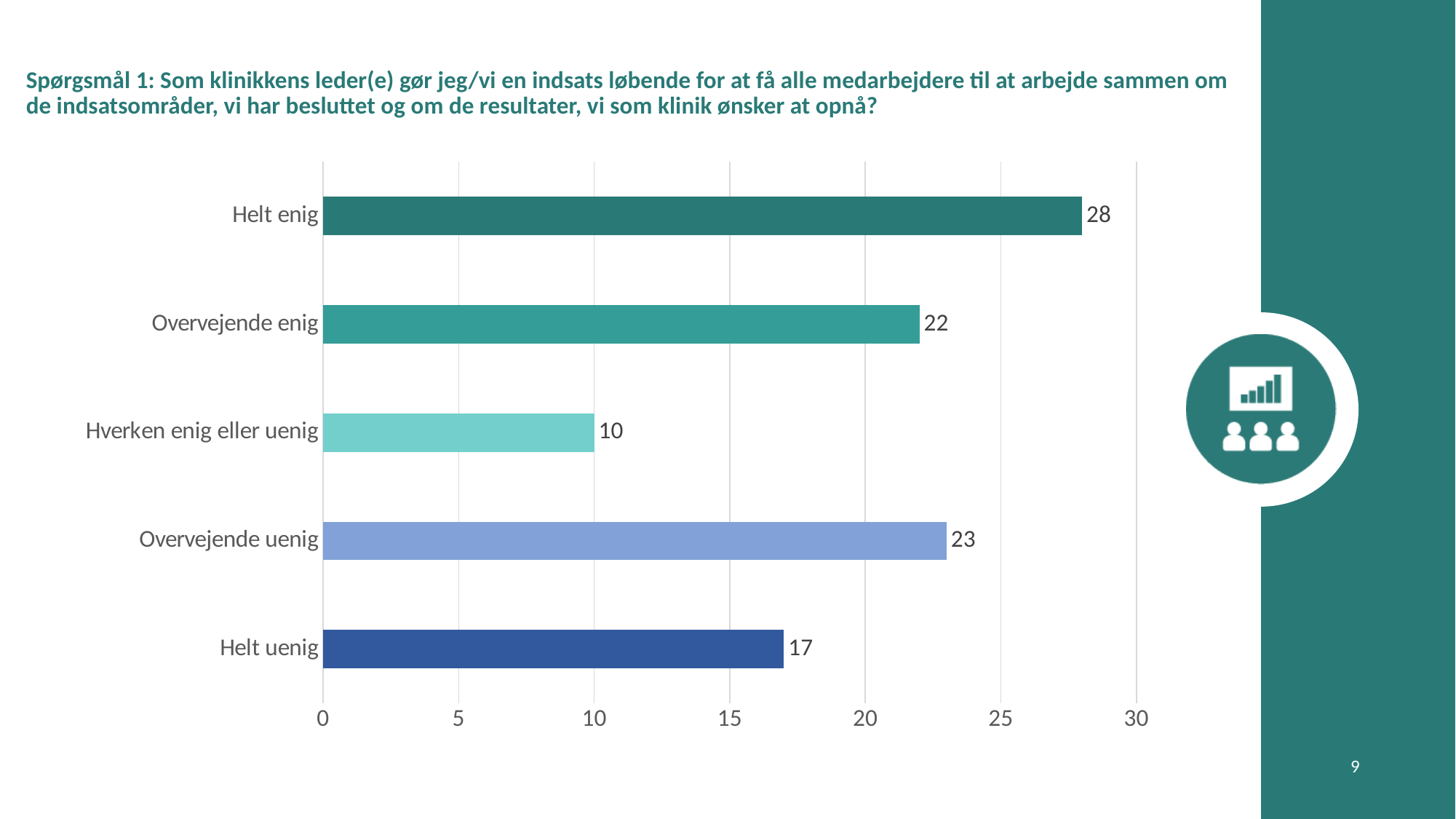
Which is larger, the value for "Overvejende uenig" or the value for "Overvejende enig"? Overvejende uenig What is the value for "Overvejende uenig"? 23 What is the value for "Hverken enig eller uenig"? 10 Which category has the lowest value? Hverken enig eller uenig What is the value for "Helt uenig"? 17 What is the value for "Helt enig"? 28 What is the total of all five values in the chart? 100 What kind of chart is shown on the slide? Bar chart What is the value for "Overvejende enig"? 22 What is the difference between the values for "Helt enig" and "Helt uenig"? 11 How many categories are shown in the chart? 5 Which category has the highest value? Helt enig